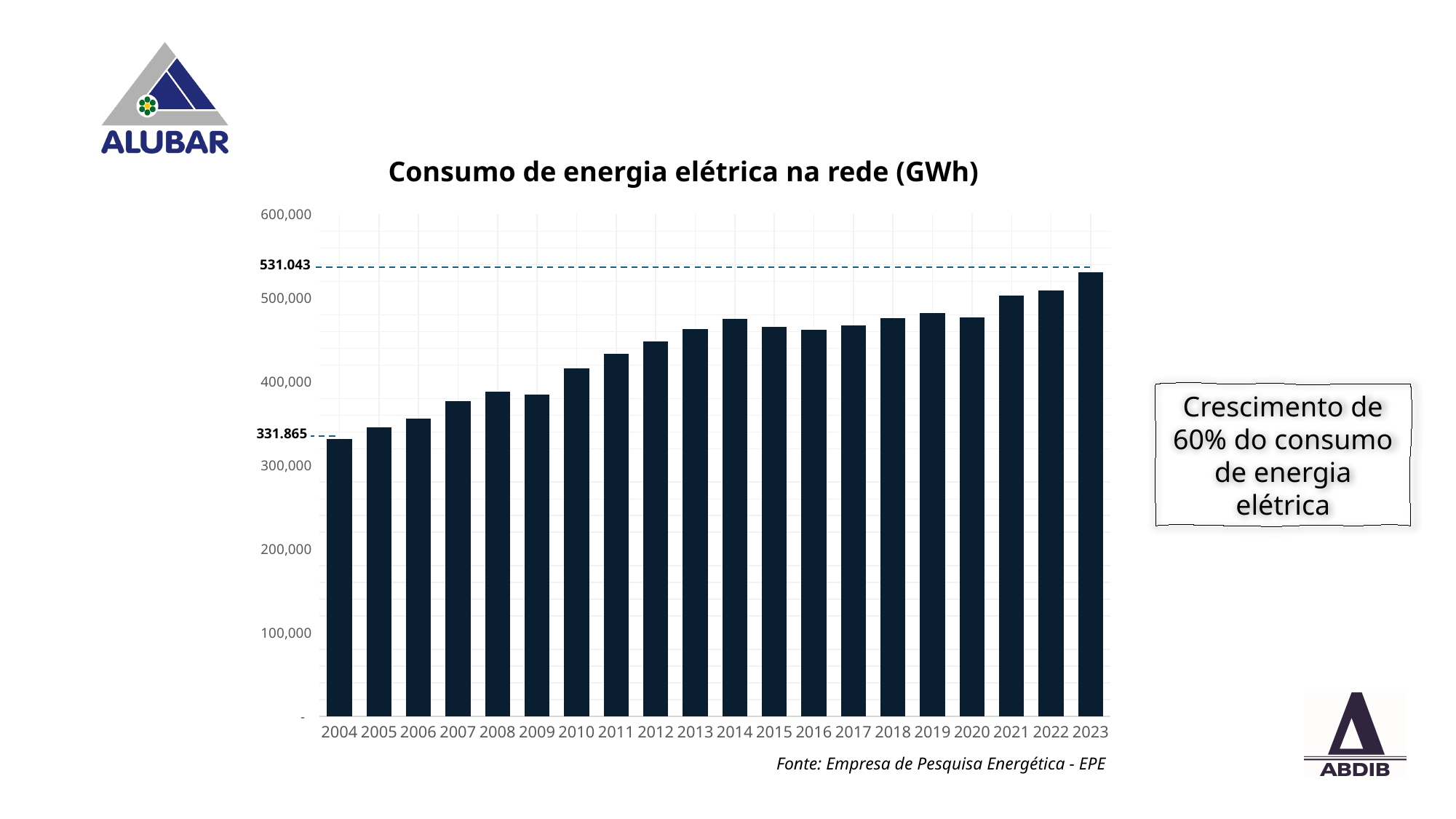
What is the electricity consumption value shown for 2023? 531.043 Do the values generally rise or fall from 2004 to 2023? rise What kind of chart is shown on the slide? bar chart How many years are plotted in the chart? 20 Is the value for 2009 greater or less than 400,000? less Is the value for 2020 greater or less than 500,000? less Which year has the lowest electricity consumption in the chart? 2004 What is the title of the chart? Consumo de energia elétrica na rede (GWh) What is the electricity consumption value shown for 2004? 331.865 Which year has the larger value, 2014 or 2016? 2014 What is the difference between the 2023 value and the 2004 value? 199.178 Which year has the highest electricity consumption in the chart? 2023